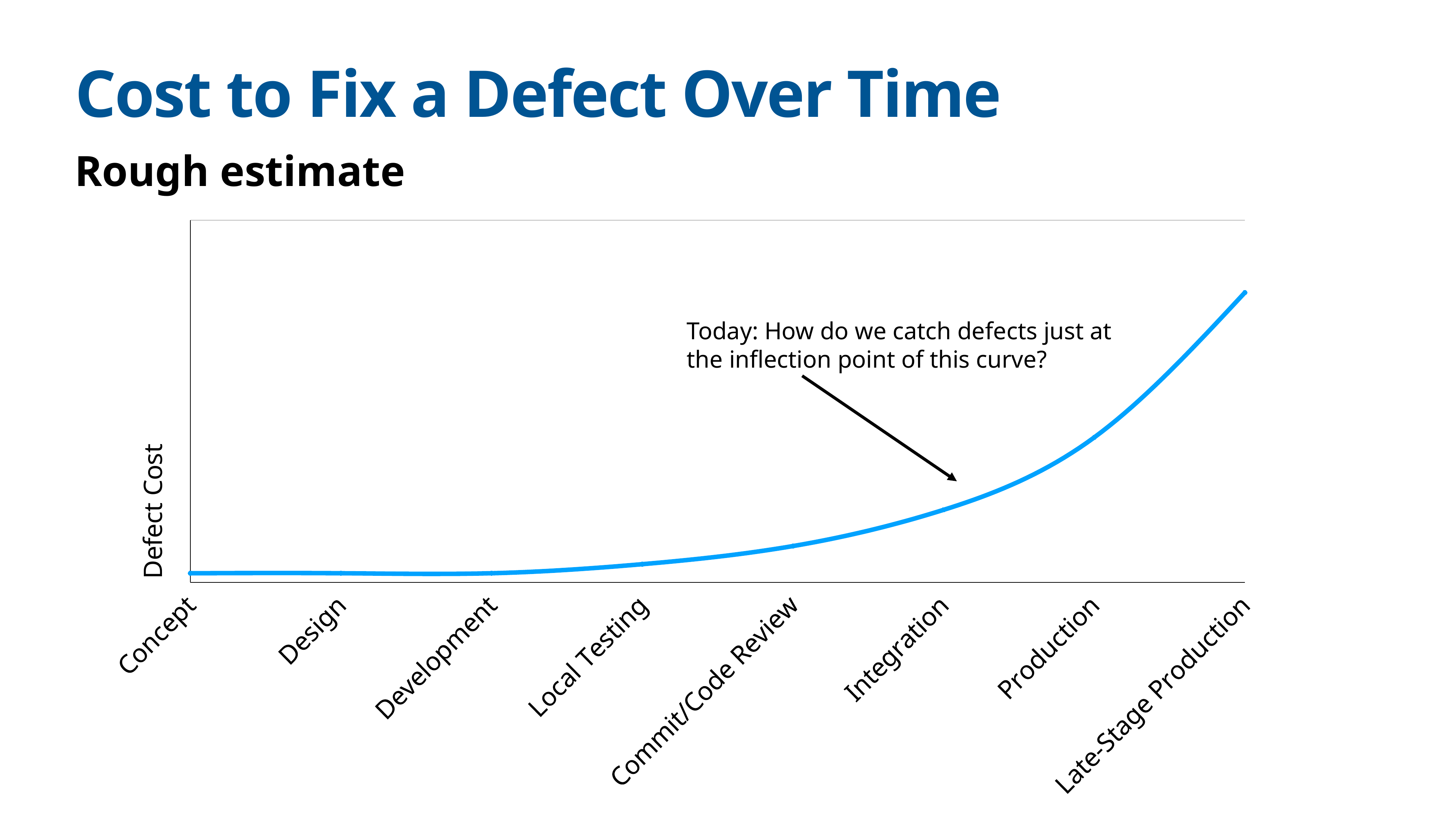
Which stage is labelled immediately after Local Testing on the x axis? Commit/Code Review What is the title of the chart on the slide? Cost to Fix a Defect Over Time Which has the higher defect cost, Integration or Design? Integration How many stages are labelled along the x axis of the chart? 8 What is the label on the y axis of the chart? Defect Cost How many lines are plotted on the chart? 1 Which stage is labelled first on the x axis of the chart? Concept What kind of chart is shown on the slide? Line chart Which has the higher defect cost, Production or Local Testing? Production Does the defect cost rise or fall as you move from Concept to Late-Stage Production along the x axis? Rises Which has the higher defect cost, Concept or Late-Stage Production? Late-Stage Production Which stage has the highest defect cost on the chart? Late-Stage Production